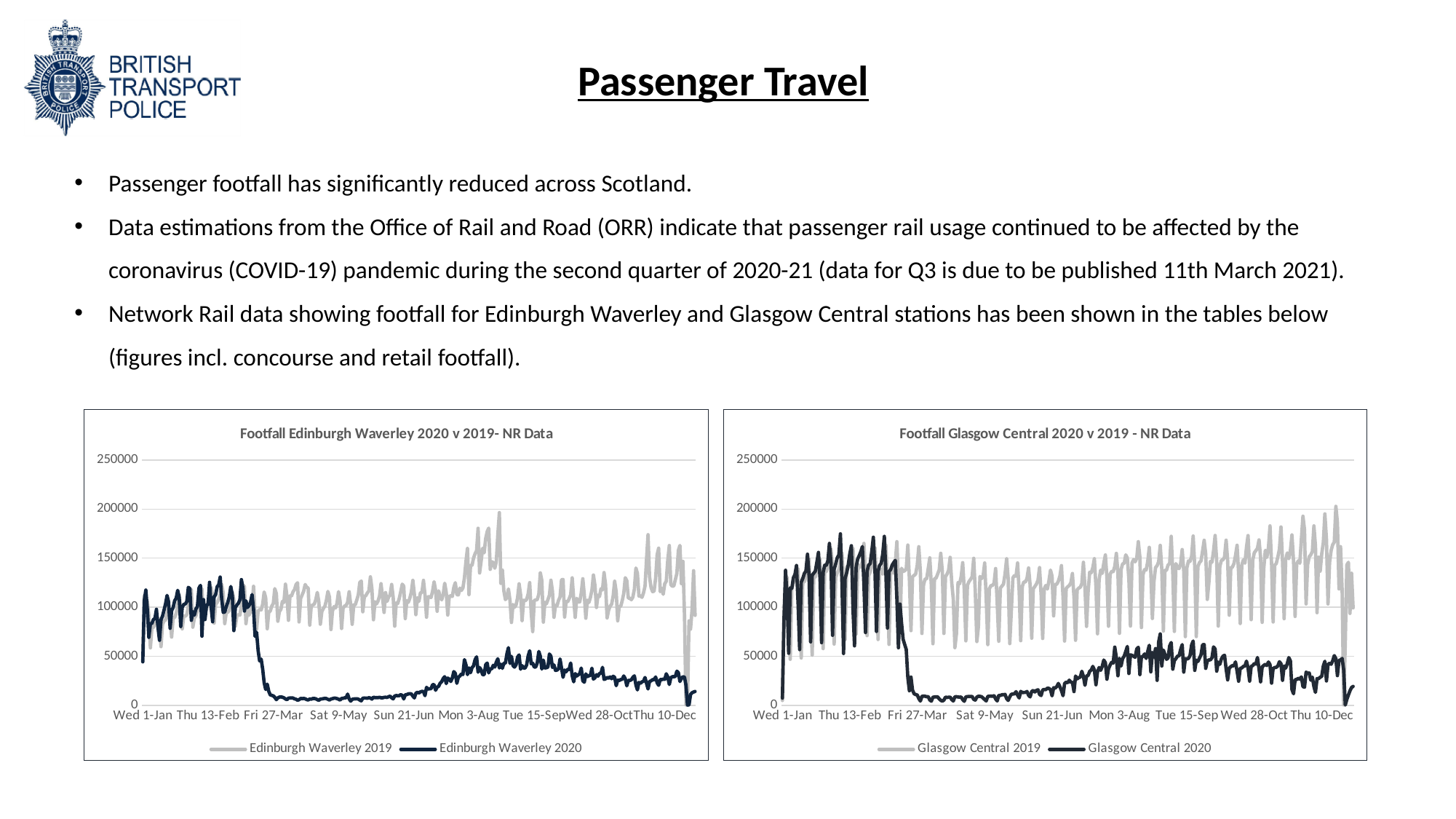
In the left chart (Footfall Edinburgh Waverley), does the Edinburgh Waverley 2020 line rise or fall between Thu 13-Feb and Fri 27-Mar? fall In the left chart (Footfall Edinburgh Waverley), is the value for Edinburgh Waverley 2020 around Sat 9-May greater or less than 50000? less How many series does the legend of the right chart (Footfall Glasgow Central 2020 v 2019) list? 2 What kind of chart is the 'Footfall Edinburgh Waverley 2020 v 2019- NR Data' chart on the left? line chart In the left chart (Footfall Edinburgh Waverley), is the highest peak of Edinburgh Waverley 2019 near Mon 3-Aug greater or less than 150000? greater What is the title of the chart on the right of the slide? Footfall Glasgow Central 2020 v 2019 - NR Data In the right chart (Footfall Glasgow Central), is the value for Glasgow Central 2020 around Sat 9-May greater or less than 50000? less In the right chart (Footfall Glasgow Central), does the Glasgow Central 2020 line generally rise or fall between Sat 9-May and Tue 15-Sep? rise What are the two legend entries of the left chart (Footfall Edinburgh Waverley 2020 v 2019)? Edinburgh Waverley 2019 and Edinburgh Waverley 2020 In the right chart (Footfall Glasgow Central), which series is higher around Sat 9-May, Glasgow Central 2019 or Glasgow Central 2020? Glasgow Central 2019 How many series does the legend of the left chart (Footfall Edinburgh Waverley 2020 v 2019) list? 2